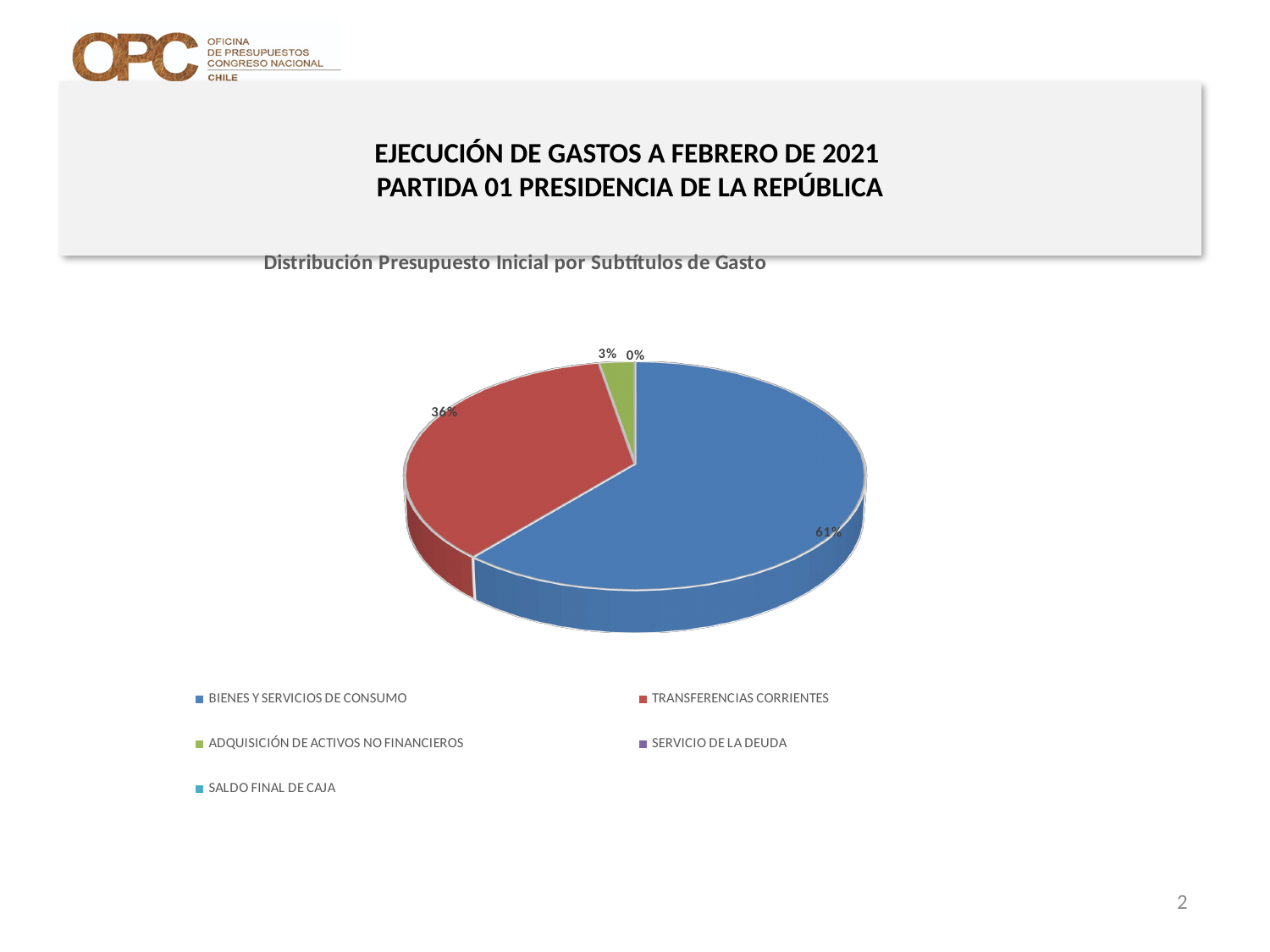
What is the combined share of BIENES Y SERVICIOS DE CONSUMO and TRANSFERENCIAS CORRIENTES? 97% What share of the pie does ADQUISICIÓN DE ACTIVOS NO FINANCIEROS represent? 3% What colour is the slice for BIENES Y SERVICIOS DE CONSUMO? blue Which is larger, the share for TRANSFERENCIAS CORRIENTES or the share for ADQUISICIÓN DE ACTIVOS NO FINANCIEROS? TRANSFERENCIAS CORRIENTES By how many percentage points does BIENES Y SERVICIOS DE CONSUMO exceed TRANSFERENCIAS CORRIENTES? 25 percentage points How many categories does the legend list? 5 What share of the pie does BIENES Y SERVICIOS DE CONSUMO represent? 61% What share of the pie does TRANSFERENCIAS CORRIENTES represent? 36% What is the title of the chart? Distribución Presupuesto Inicial por Subtítulos de Gasto What kind of chart is shown on the slide? pie chart Is the share for BIENES Y SERVICIOS DE CONSUMO greater or less than 50%? greater Which category has the largest slice of the pie? BIENES Y SERVICIOS DE CONSUMO